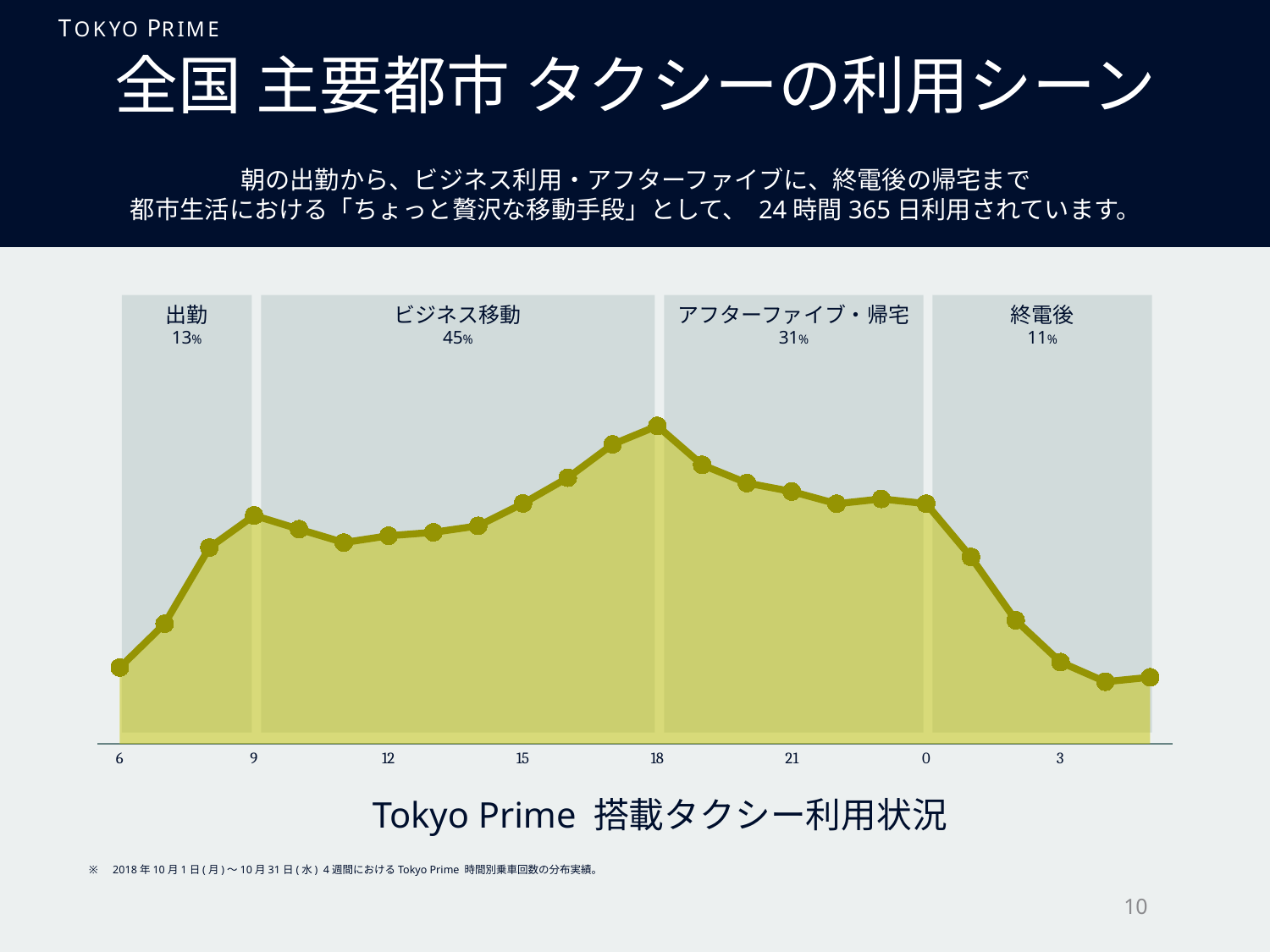
At which hour on the x axis does the plotted line reach its peak? 18 Which segment has a larger share, 出勤 or 終電後? 出勤 What percentage is shown for the 出勤 segment of the chart? 13% Which labelled segment has the lowest percentage? 終電後 Does the plotted line rise or fall between 18 and 3 on the x axis? fall Which labelled segment has the highest percentage? ビジネス移動 What percentage is shown for the 終電後 segment? 11% What is the difference in percentage points between the ビジネス移動 and アフターファイブ・帰宅 segments? 14 What percentage is shown for the ビジネス移動 segment? 45% How many labelled segments (time-of-day categories) are shown above the chart? 4 What percentage is shown for the アフターファイブ・帰宅 segment? 31% What is the title shown below the chart? Tokyo Prime 搭載タクシー利用状況